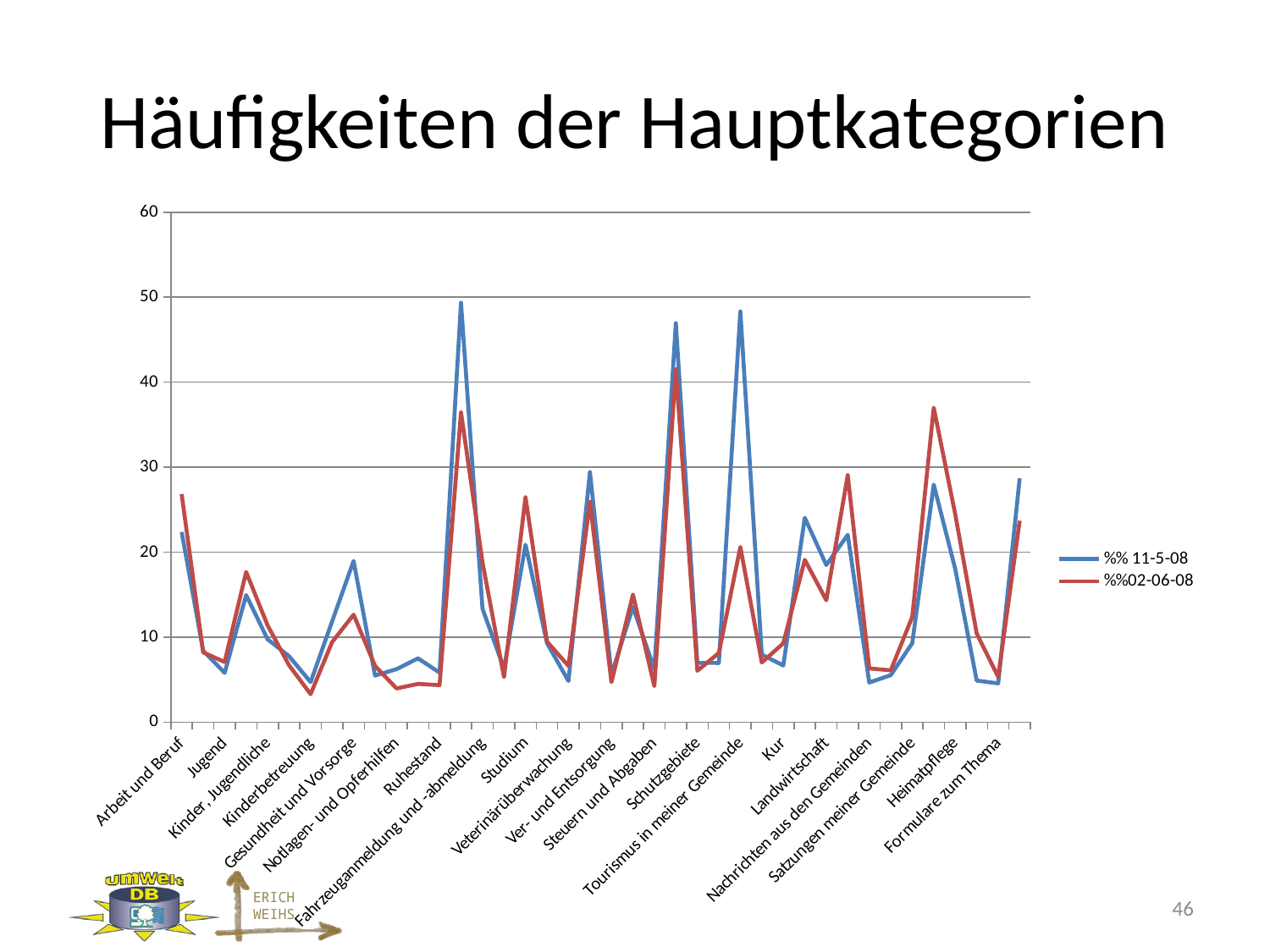
What is the maximum value shown on the vertical axis? 60 Is the value of the %% 11-5-08 series for Arbeit und Beruf greater or less than 30? less Is the value of the %%02-06-08 series for Arbeit und Beruf greater or less than 20? greater For Arbeit und Beruf, which series has the higher value, %% 11-5-08 or %%02-06-08? %%02-06-08 What is the title of the chart? Häufigkeiten der Hauptkategorien What are the two series names shown in the legend? %% 11-5-08 and %%02-06-08 Is the highest point of the %% 11-5-08 series greater or less than 40? greater How many series does the legend list? 2 What kind of chart is shown on the slide? line chart